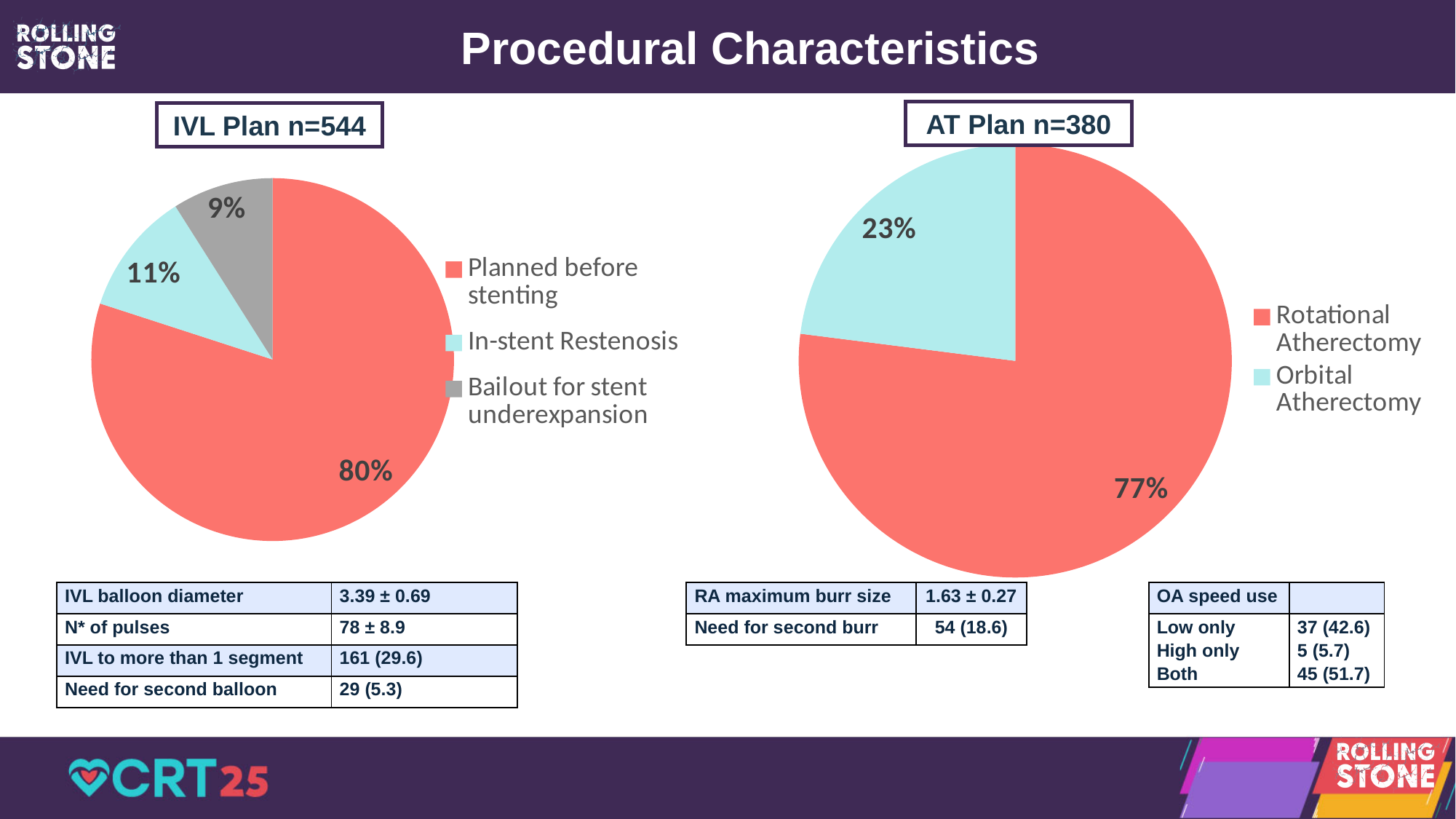
In the IVL Plan n=544 pie chart, what share is labelled for Bailout for stent underexpansion? 9% In the IVL Plan n=544 pie chart, which category has the largest slice? Planned before stenting In the AT Plan n=380 pie chart, what share is labelled for Orbital Atherectomy? 23% In the IVL Plan n=544 pie chart, which category has the smallest slice? Bailout for stent underexpansion What type of chart is the AT Plan n=380 chart? Pie chart In the AT Plan n=380 pie chart, what share is labelled for Rotational Atherectomy? 77% In the AT Plan n=380 pie chart, what is the difference in percentage points between Rotational Atherectomy and Orbital Atherectomy? 54 In the AT Plan n=380 pie chart, which is larger, Rotational Atherectomy or Orbital Atherectomy? Rotational Atherectomy In the IVL Plan n=544 pie chart, how many slices are there? 3 In the AT Plan n=380 pie chart, how many entries does the legend list? 2